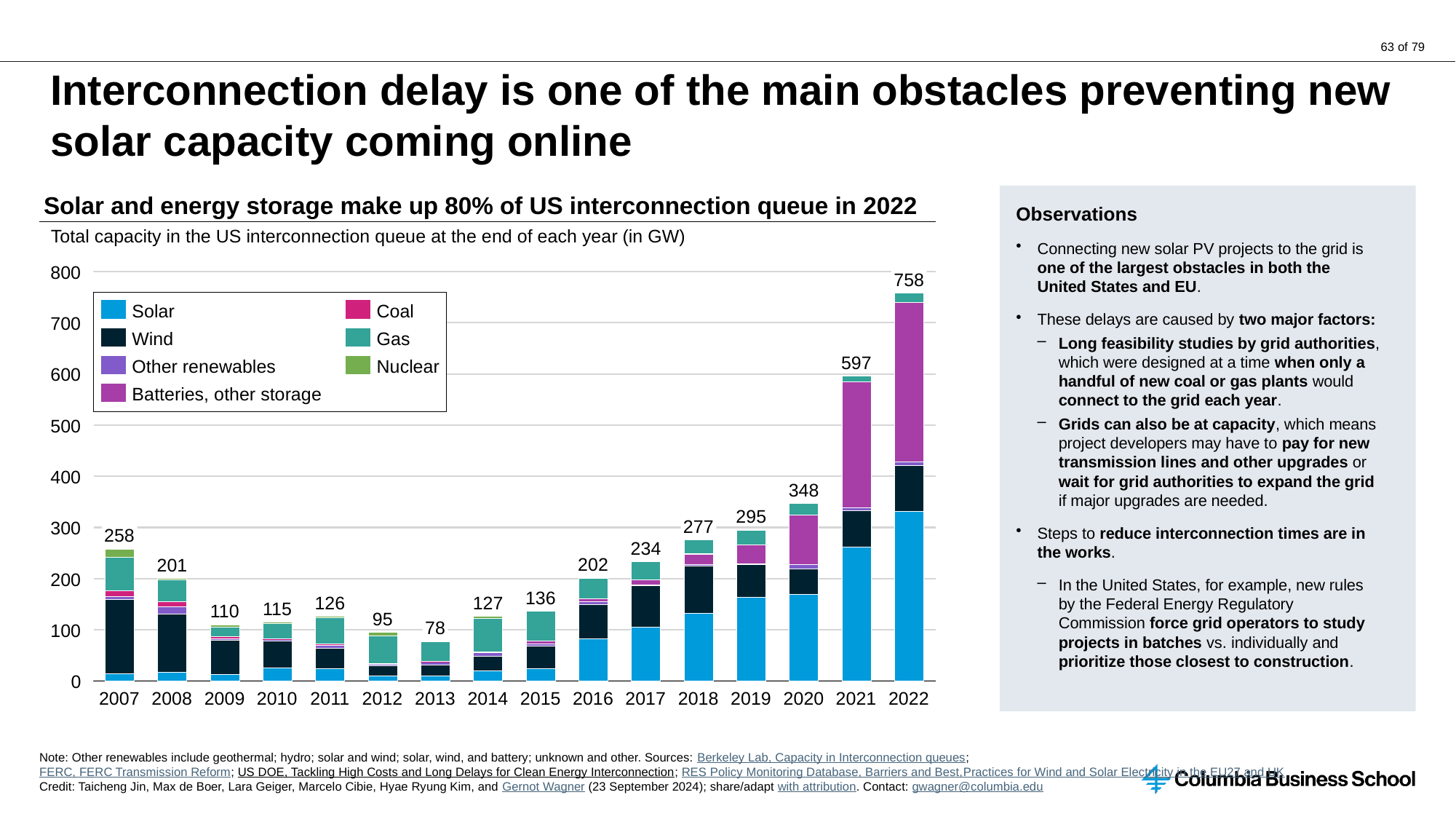
How many series does the chart legend list? 7 Do the total queue capacities rise or fall from 2016 to 2022? Rise What is the total capacity in the US interconnection queue at the end of 2007? 258 What is the difference between the total queue capacity in 2022 and in 2021? 161 How many years are shown on the x axis of the chart? 16 Is the Solar segment for 2022 greater or less than 300 GW? greater Which year has a larger total queue capacity, 2007 or 2008? 2007 What kind of chart is shown on the slide? Stacked bar chart Which year has the highest total capacity in the interconnection queue? 2022 Which year has the lowest total capacity in the interconnection queue? 2013 What is the difference between the total queue capacity in 2020 and in 2019? 53 What is the total capacity in the US interconnection queue at the end of 2022? 758